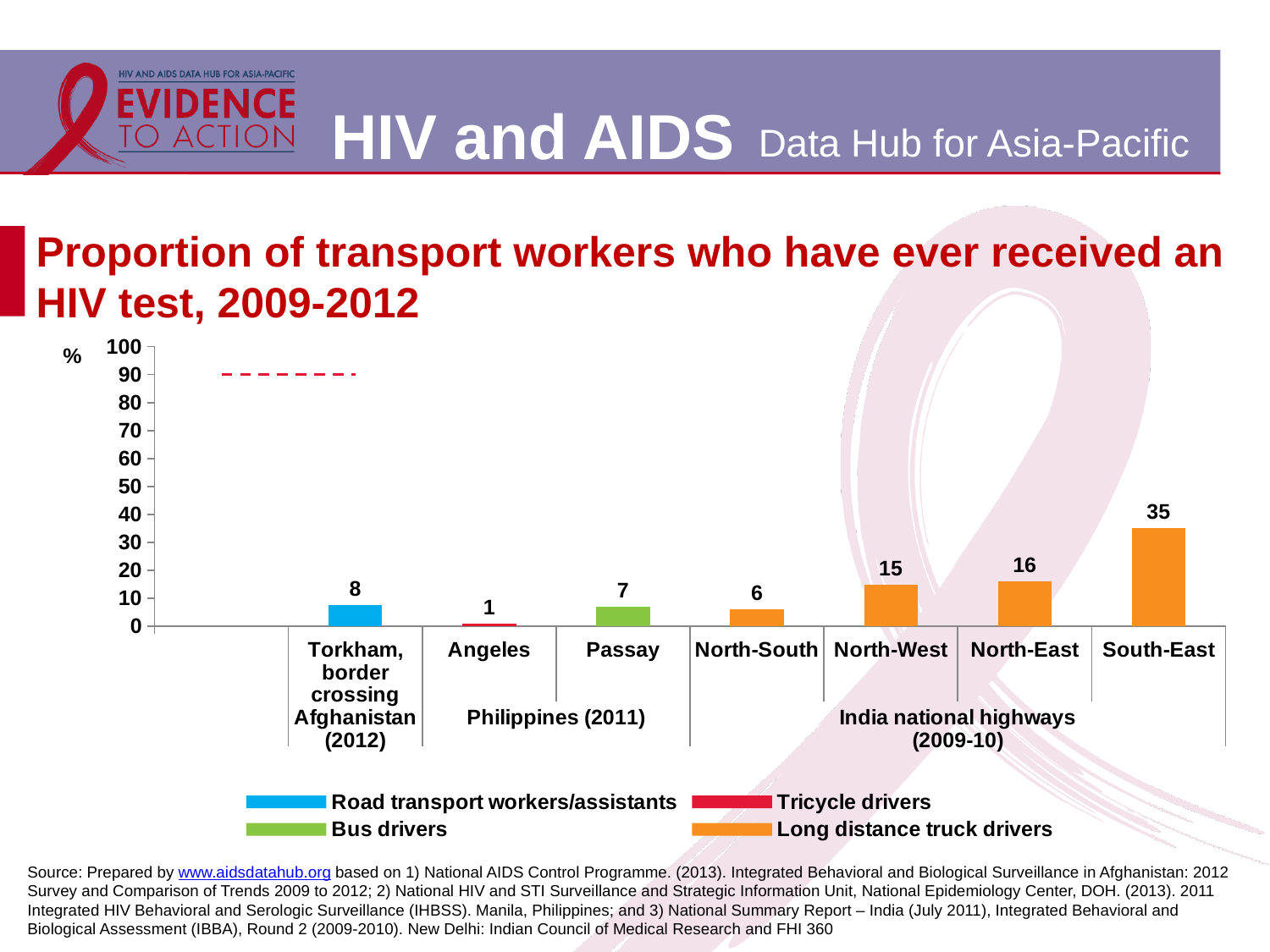
How many series does the legend list? 4 Which category has the highest value? South-East How many bars are plotted on the chart? 7 Which has a larger value, North-West or Passay? North-West What is the value for Torkham, border crossing Afghanistan (2012)? 8 What is the value for Angeles in the Philippines? 1 Is the value for South-East greater or less than 30? greater What kind of chart is shown on the slide? bar chart Which legend series does the South-East bar belong to? Long distance truck drivers What is the difference between the values for South-East and North-East? 19 Which category has the lowest value? Angeles What is the value for South-East on the India national highways? 35